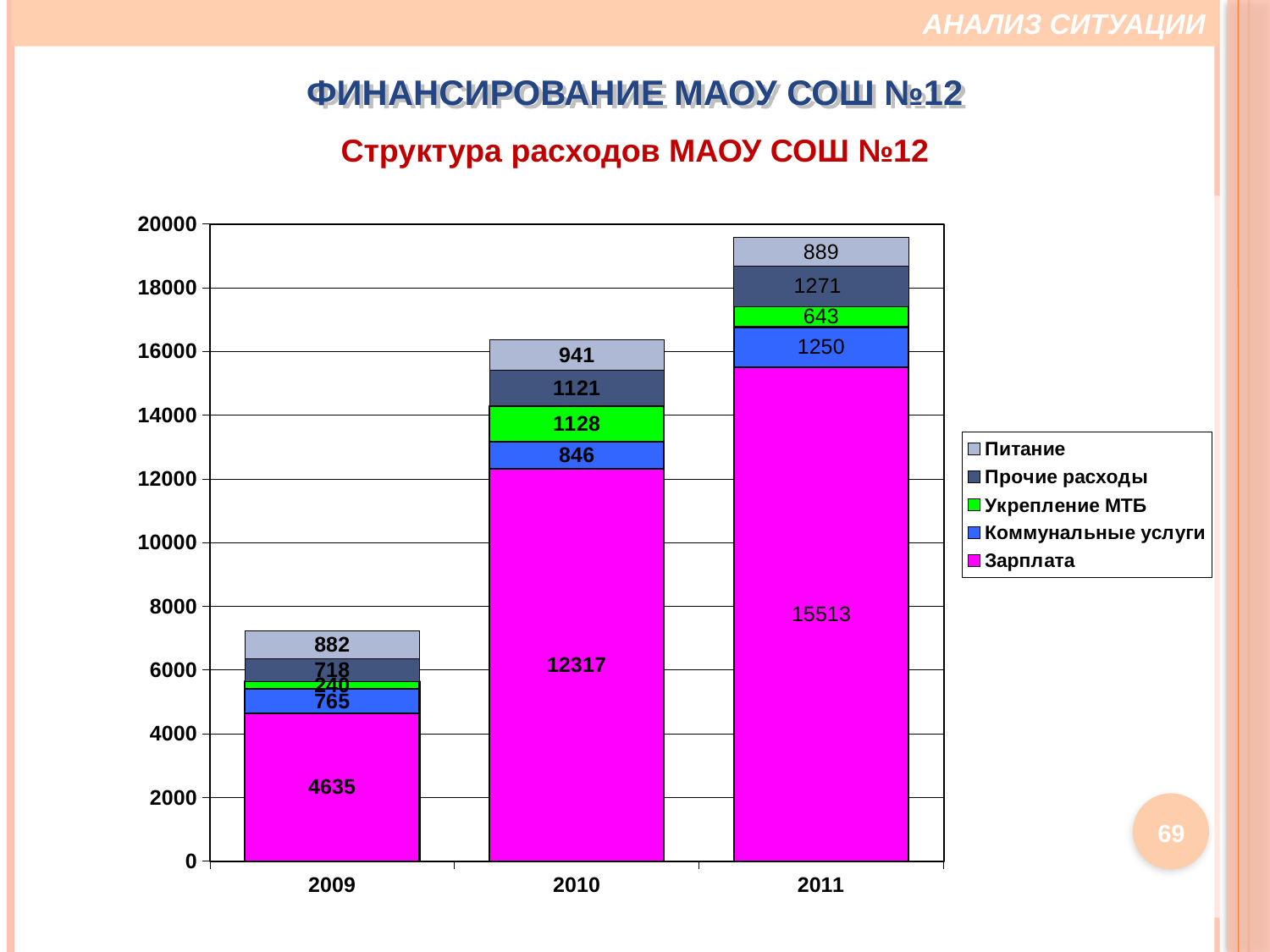
In which year is Укрепление МТБ the lowest? 2009 What is the total of the stacked bar for 2009? 7240 What is the value of Зарплата in 2011? 15513 How many years (categories) are shown on the x axis? 3 What is the value of Коммунальные услуги in 2009? 765 Which is larger: Питание in 2010 or Питание in 2011? Питание in 2010 In which year is Зарплата the highest? 2011 What is the difference between Зарплата in 2010 and in 2009? 7682 Does the total expenditure rise or fall from 2009 to 2011? rise What is the value of Укрепление МТБ in 2010? 1128 What type of chart is shown on the slide? stacked bar chart How many series does the legend list? 5